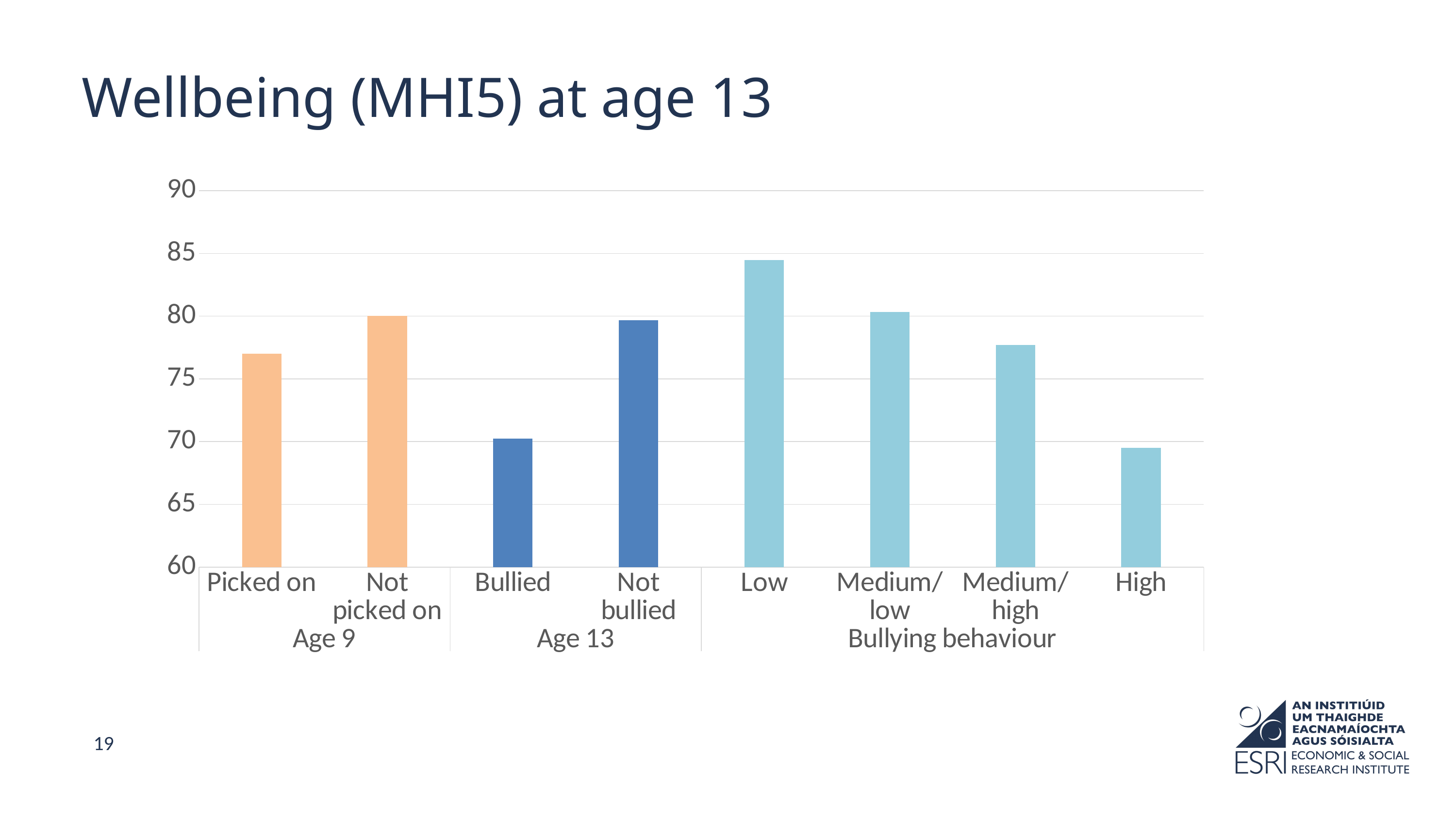
How many bars are plotted in the chart? 8 Which is larger, the value for Picked on or for Not picked on? Not picked on Is the value for Bullied greater or less than 75? less Is the value for High greater or less than 75? less How many category groups are shown along the x axis? 3 What is the title of the chart? Wellbeing (MHI5) at age 13 Which is larger, the value for Bullied or for Not bullied? Not bullied Is the value for Low greater or less than 80? greater Across the Bullying behaviour group from Low to High, do the values rise or fall? fall What kind of chart is shown on the slide? bar chart Which category has the highest value in the chart? Low Within the Bullying behaviour group, which category has the lowest value? High